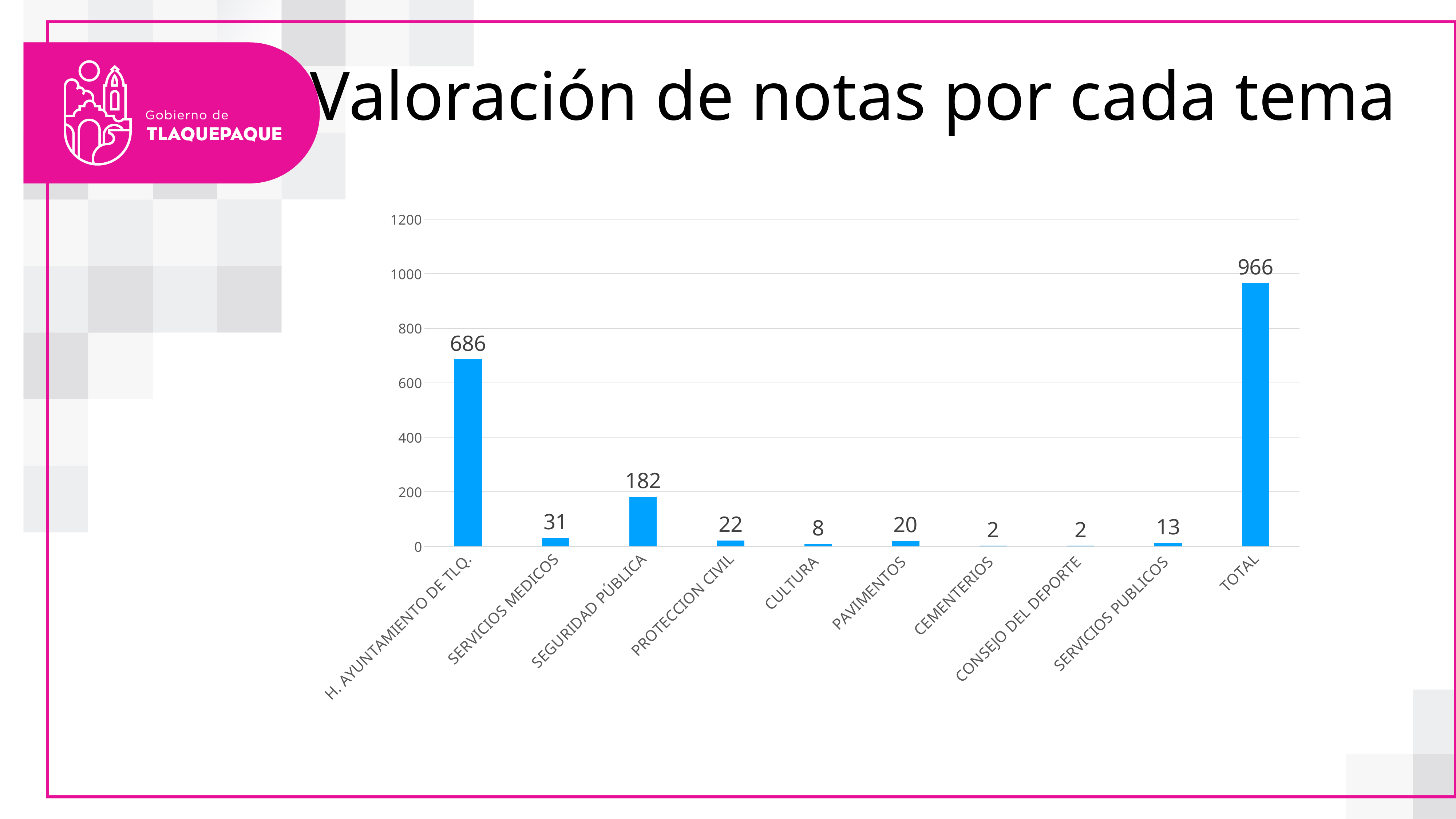
Excluding the TOTAL bar, which category has the highest value? H. AYUNTAMIENTO DE TLQ. Which category has the lowest value, CULTURA or PAVIMENTOS? CULTURA What is the difference between the values for H. AYUNTAMIENTO DE TLQ. and SEGURIDAD PÚBLICA? 504 What is the difference between the values for SERVICIOS MEDICOS and PROTECCION CIVIL? 9 What is the value for SERVICIOS PUBLICOS? 13 What is the value for H. AYUNTAMIENTO DE TLQ.? 686 What is the title of the slide? Valoración de notas por cada tema Is the value for H. AYUNTAMIENTO DE TLQ. greater or less than 600? greater What is the value for SEGURIDAD PÚBLICA? 182 How many bars are shown in the chart? 10 What kind of chart is shown on the slide? Bar chart What is the value for the TOTAL bar? 966